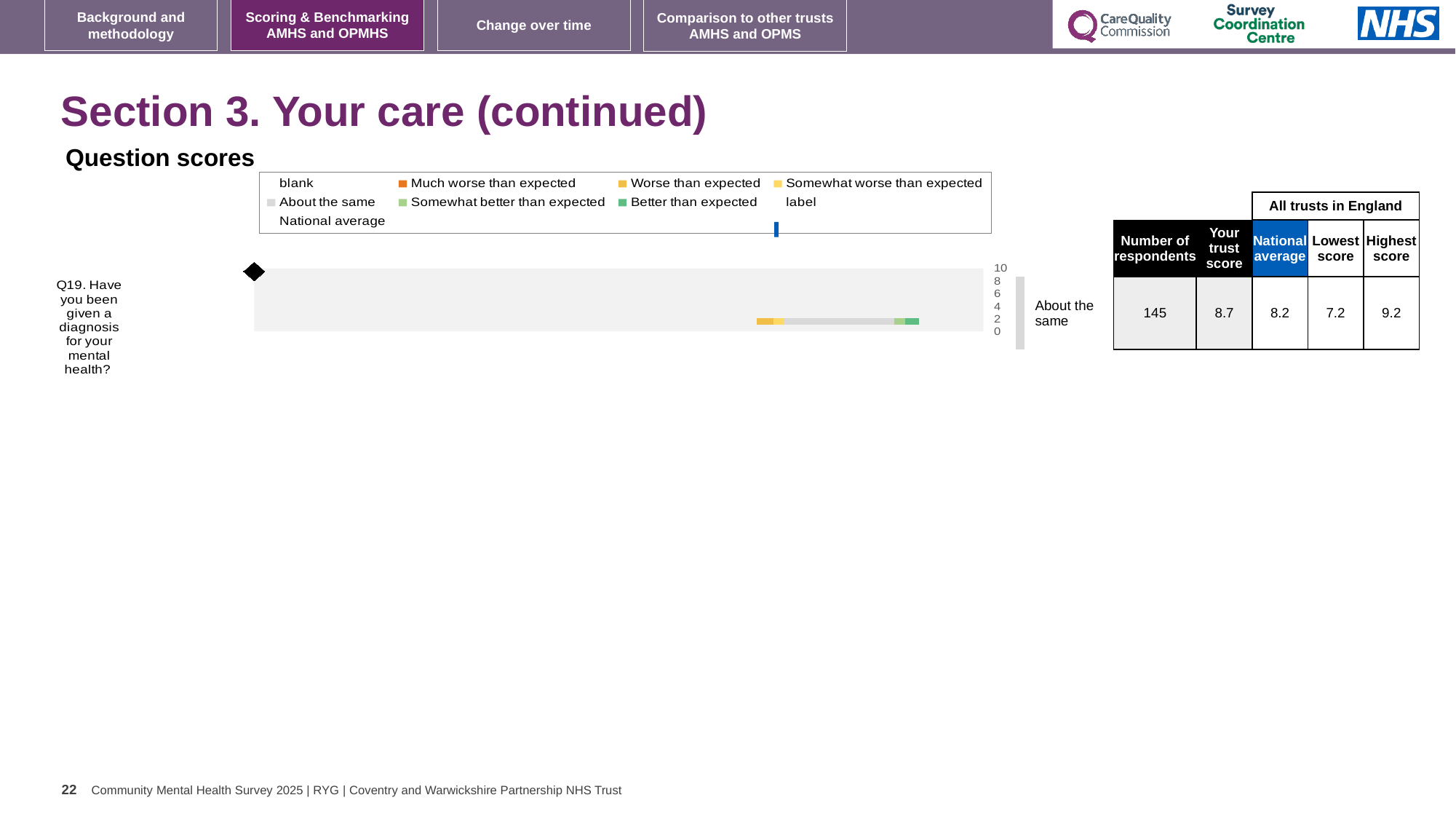
What is the number of respondents for Q19? 145 What kind of chart is shown under "Question scores"? bar chart What is the lowest score among all trusts in England for Q19? 7.2 What is the national average for Q19? 8.2 What is your trust score for Q19? 8.7 How many questions are plotted in the Question scores chart? 1 What category label is shown to the right of the bar for Q19? About the same What colour represents "Much worse than expected" in the legend? Orange Which question is plotted in the Question scores chart? Q19. Have you been given a diagnosis for your mental health? Which is larger for Q19, your trust score or the national average? Your trust score What is the difference between the highest score and the lowest score for Q19? 2.0 What is the highest score among all trusts in England for Q19? 9.2